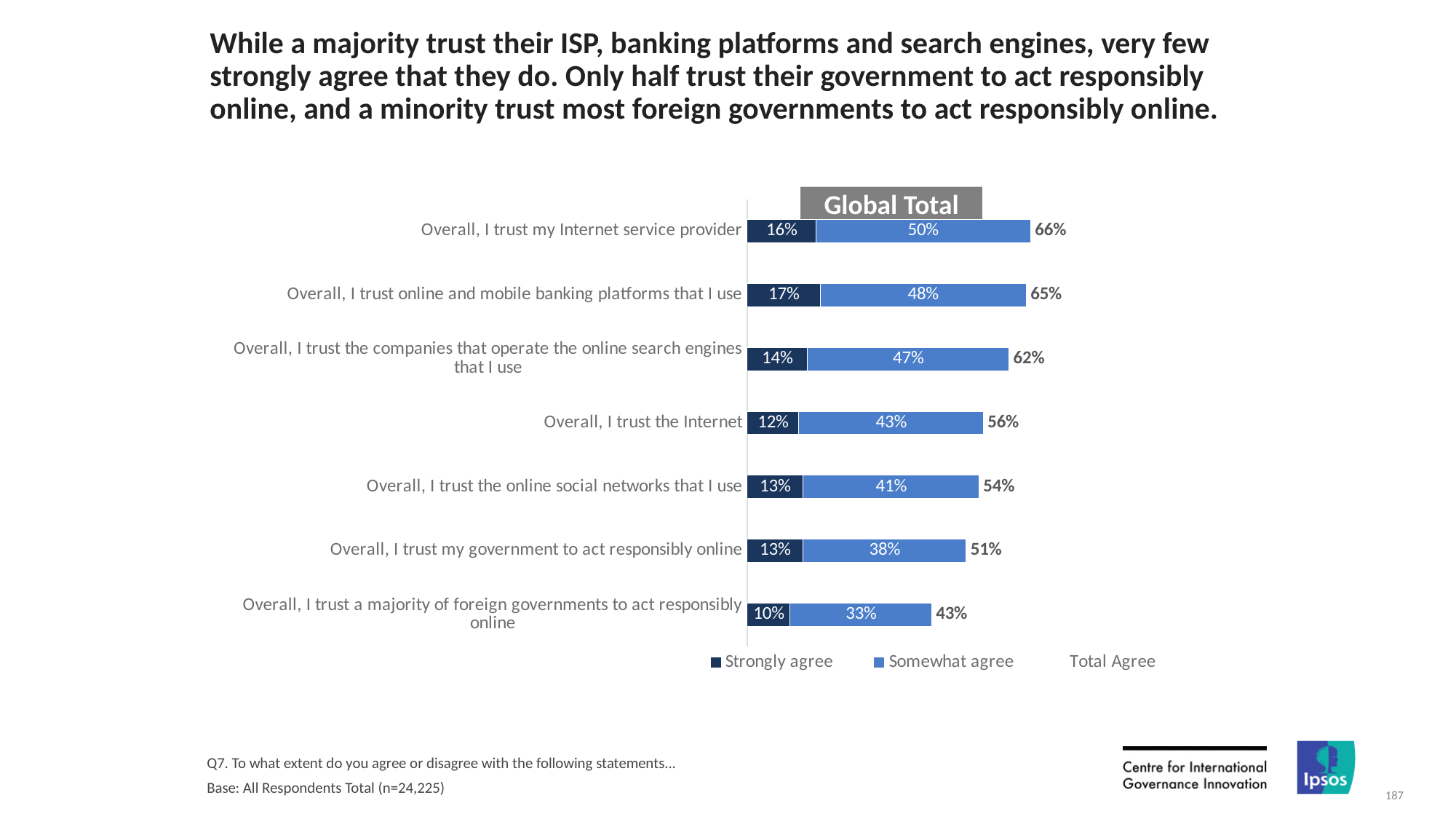
Which has a higher Somewhat agree value: trusting the online social networks that I use, or trusting the companies that operate the online search engines that I use? Overall, I trust the companies that operate the online search engines that I use How many entries does the legend list? 3 What is the total of the stacked bar for 'Overall, I trust the online social networks that I use'? 54% Which statement has the highest Total Agree value? Overall, I trust my Internet service provider Which statement has the lowest Strongly agree value? Overall, I trust a majority of foreign governments to act responsibly online What is the Somewhat agree value for 'Overall, I trust my government to act responsibly online'? 38% What is the Total Agree value for 'Overall, I trust the Internet'? 56% How many statements are shown in the chart? 7 What percentage of respondents strongly agree that they trust their Internet service provider? 16% What is the heading shown above the chart? Global Total What is the difference in Total Agree between trusting online and mobile banking platforms and trusting a majority of foreign governments to act responsibly online? 22% What kind of chart is shown on the slide? Stacked bar chart